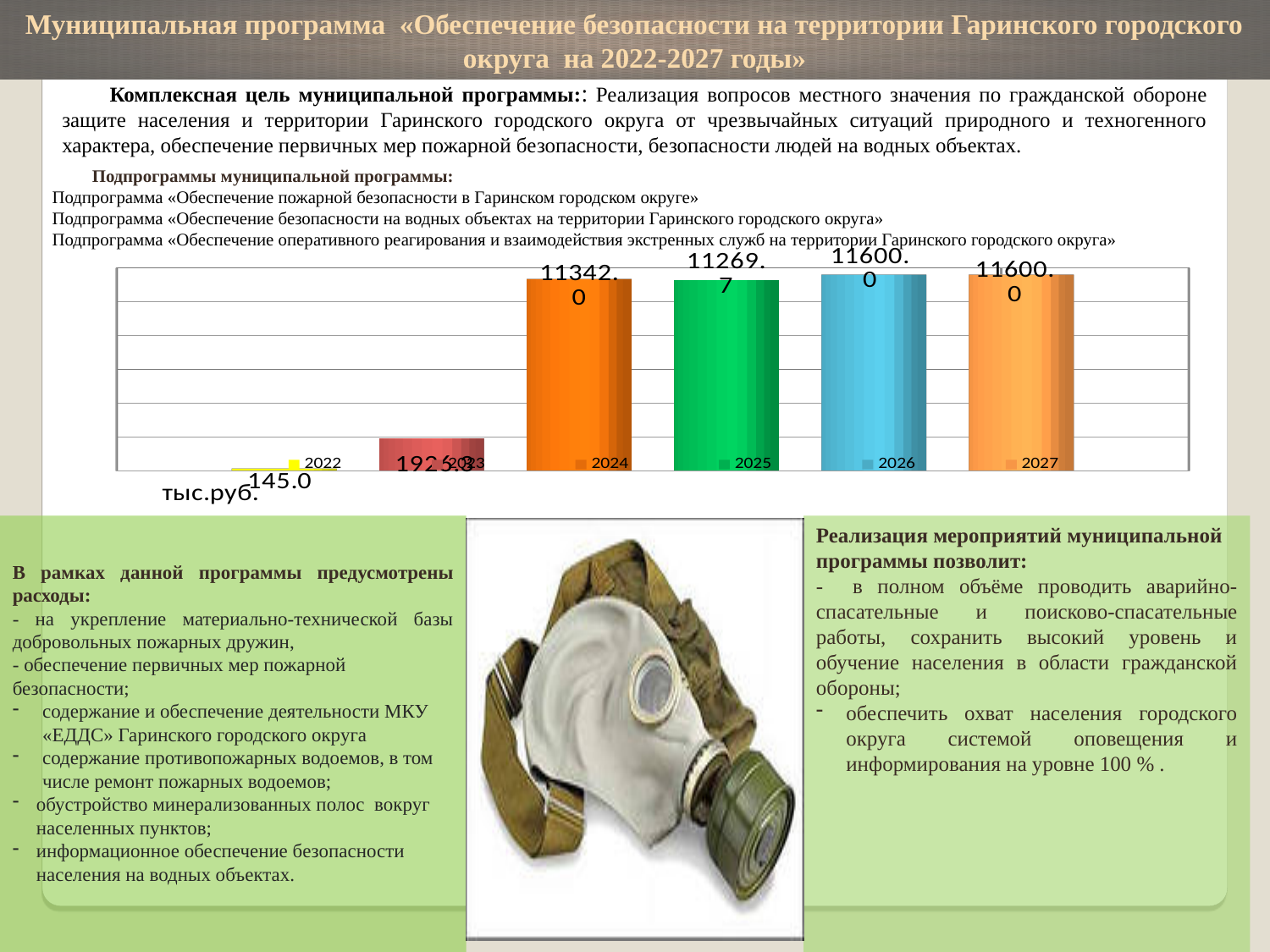
How many entries does the chart legend list? 6 What is the value shown for 2024? 11342.0 What kind of chart is shown on the slide? bar chart Do the values rise or fall from 2022 to 2024? rise What is the value shown for 2026? 11600.0 Which year has the lowest value in the chart? 2022 What is the difference between the values for 2026 and 2024? 258.0 How many years (categories) are plotted in the chart? 6 Which is larger, the value for 2024 or the value for 2025? 2024 What unit is written below the chart's vertical axis? тыс.руб. What is the value shown for 2025? 11269.7 What is the value shown for 2022? 145.0